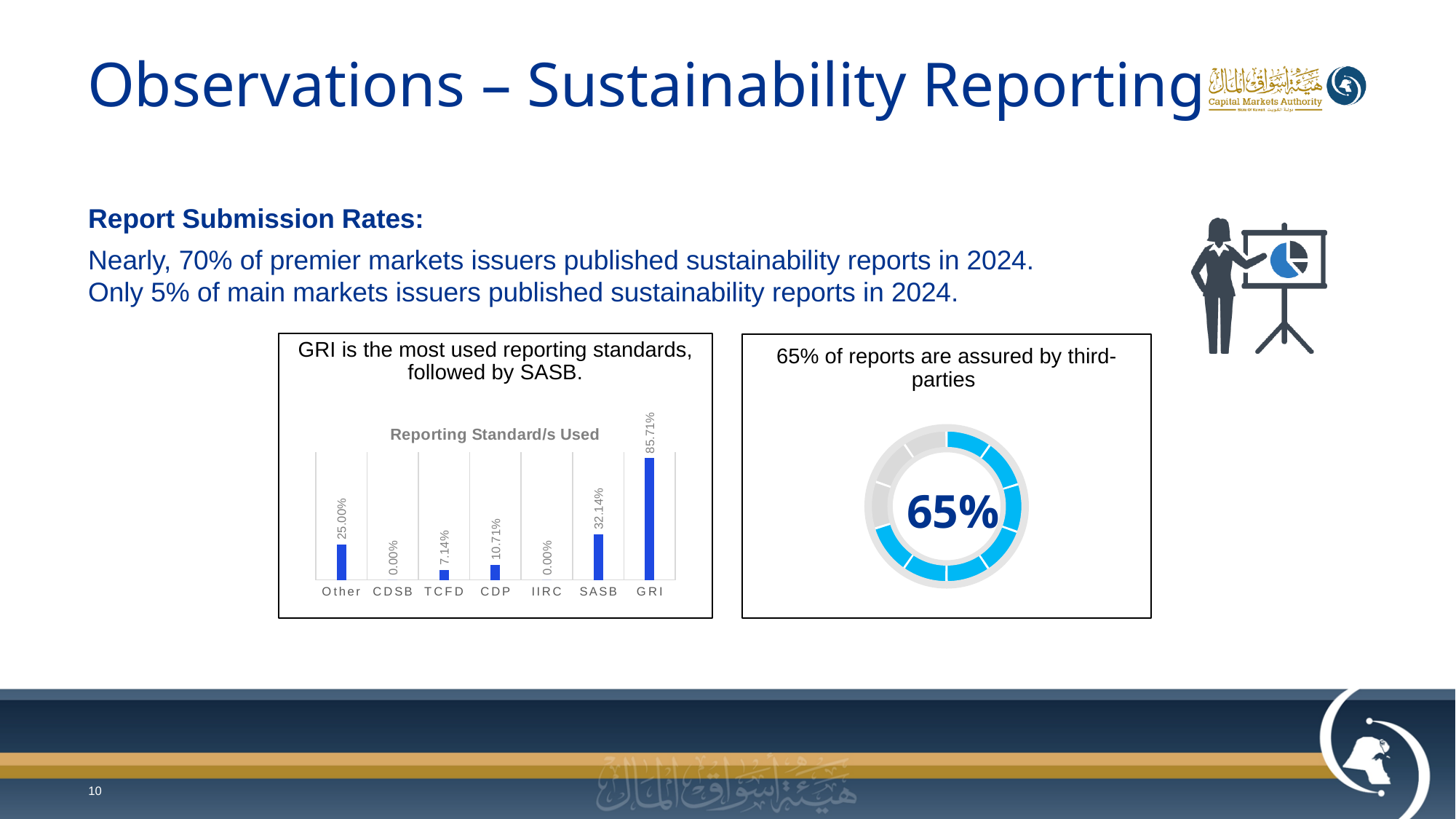
How many categories are shown in the 'Reporting Standard/s Used' chart? 7 In the 'Reporting Standard/s Used' chart, which category has the highest value? GRI In the 'Reporting Standard/s Used' chart, which categories have a value of 0.00%? CDSB and IIRC What percentage is shown in the centre of the donut chart on the right? 65% In the 'Reporting Standard/s Used' chart, what is the value for CDP? 10.71% In the 'Reporting Standard/s Used' chart, which is larger, the value for Other or the value for CDP? Other In the 'Reporting Standard/s Used' chart, what is the value for Other? 25.00% In the 'Reporting Standard/s Used' chart, what is the value for GRI? 85.71% What kind of chart is the 'Reporting Standard/s Used' chart? Bar chart In the 'Reporting Standard/s Used' chart, what is the difference between the values for GRI and SASB? 53.57% In the 'Reporting Standard/s Used' chart, what is the value for TCFD? 7.14% In the 'Reporting Standard/s Used' chart, what is the value for SASB? 32.14%